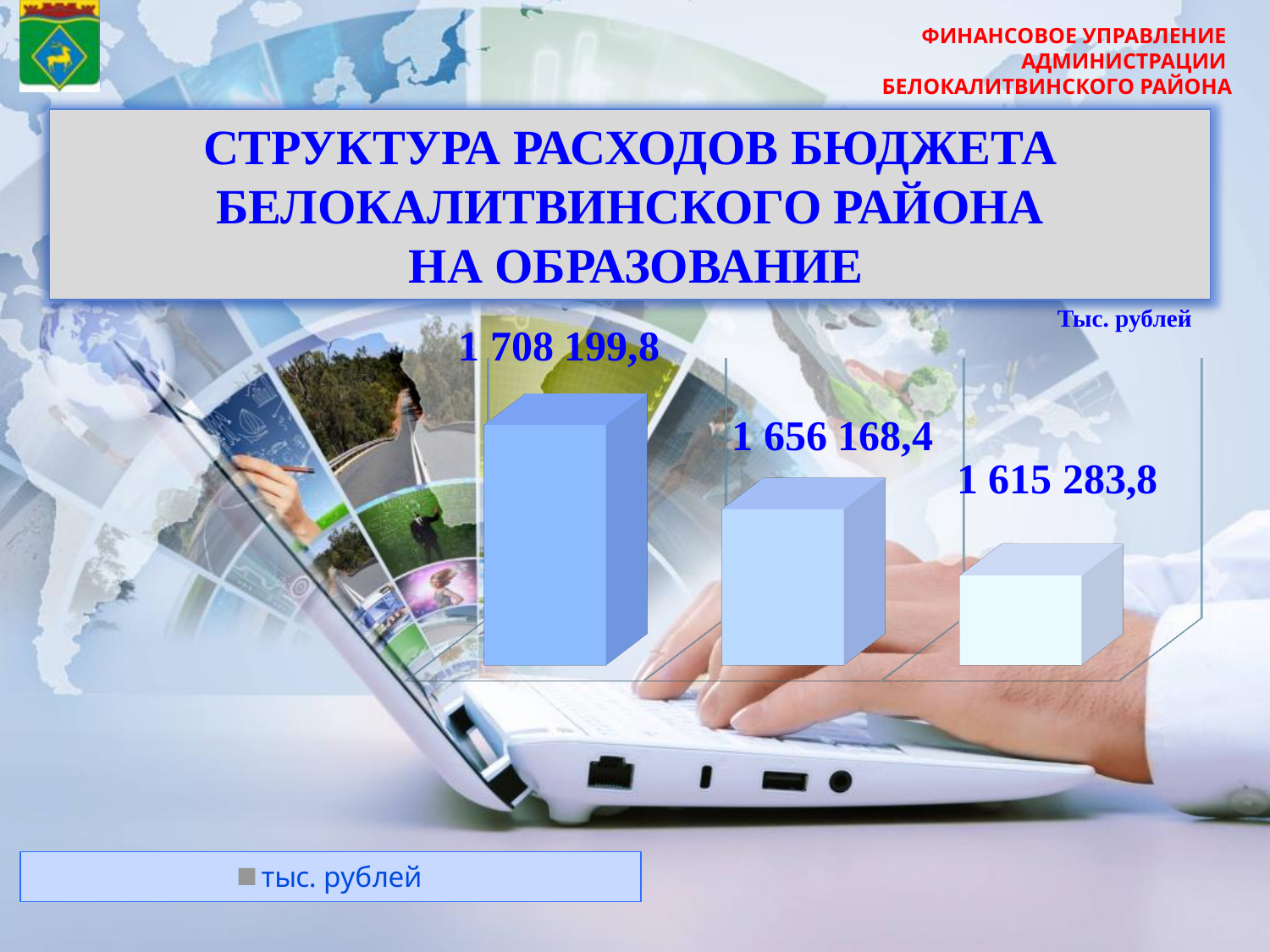
What is the difference between the leftmost bar's value and the rightmost bar's value? 92 916,0 How many bars are plotted in the chart? 3 What is the difference between the middle bar's value and the rightmost bar's value? 40 884,6 Which bar has the highest value: the left, middle or right one? the left one Which is larger: the value of the middle bar or the value of the rightmost bar? the middle bar What kind of chart is shown on the slide? bar chart What is the value shown on the middle bar? 1 656 168,4 What is the value shown on the rightmost bar? 1 615 283,8 Do the bar values rise or fall from left to right? fall Which bar has the lowest value: the left, middle or right one? the right one What is the value shown on the leftmost bar? 1 708 199,8 What is the difference between the leftmost bar's value and the middle bar's value? 52 031,4